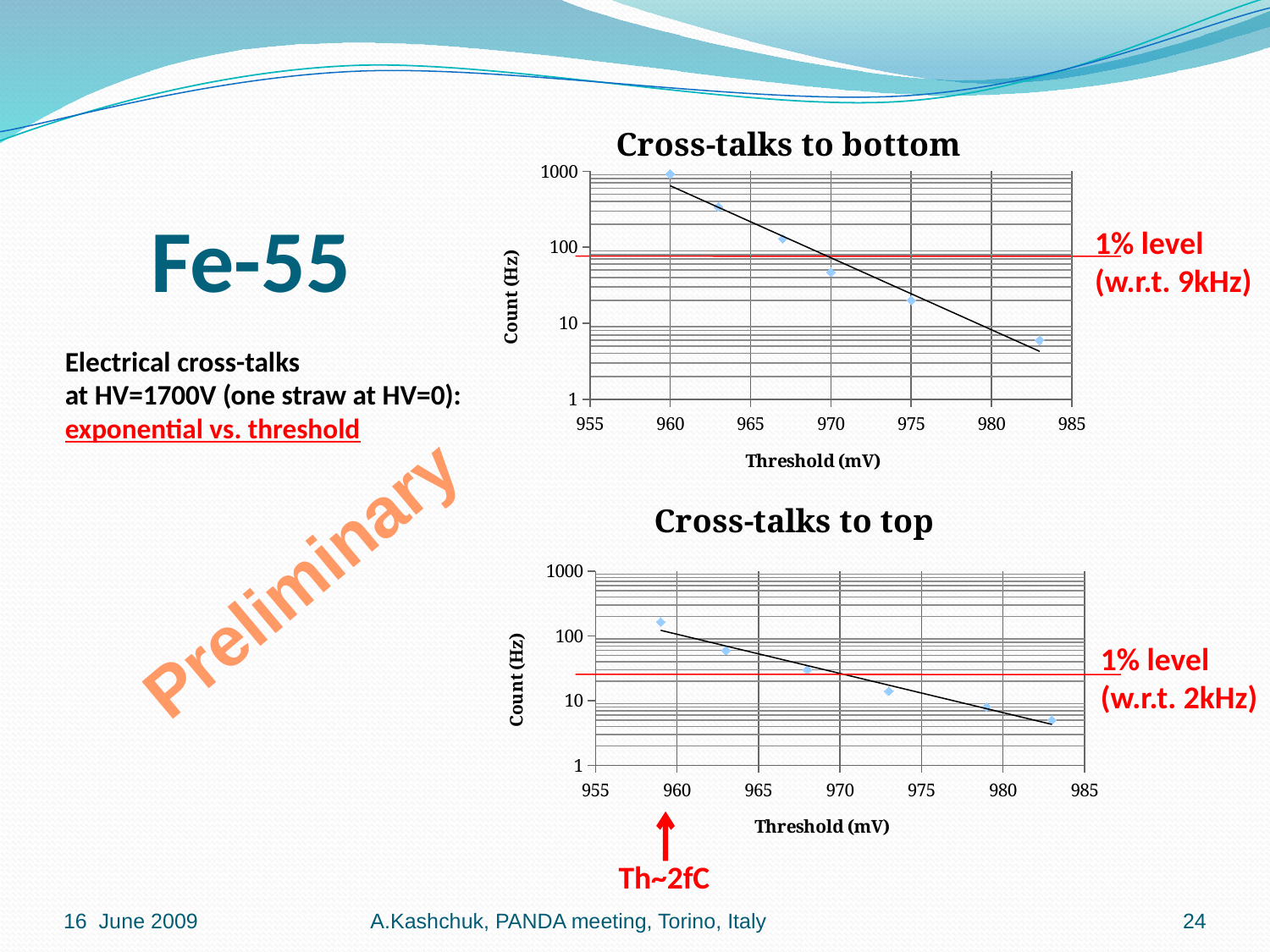
In the "Cross-talks to bottom" chart, do the counts rise or fall as the threshold increases? fall In the "Cross-talks to bottom" chart, is the count for the rightmost data point (near 983 mV) greater or less than 10? less In the "Cross-talks to bottom" chart, which has the larger count: the leftmost data point or the rightmost data point? the leftmost data point What is the x-axis title of the "Cross-talks to top" chart? Threshold (mV) How many data points are plotted in the "Cross-talks to top" chart? 6 What is the y-axis title of the "Cross-talks to bottom" chart? Count (Hz) What kind of chart is "Cross-talks to bottom"? scatter chart In the "Cross-talks to top" chart, is the count for the leftmost data point (near 959 mV) greater or less than 100? greater In the "Cross-talks to top" chart, is the count for the rightmost data point (near 983 mV) greater or less than 10? less How many data points are plotted in the "Cross-talks to bottom" chart? 6 In the "Cross-talks to top" chart, do the counts rise or fall as the threshold increases? fall